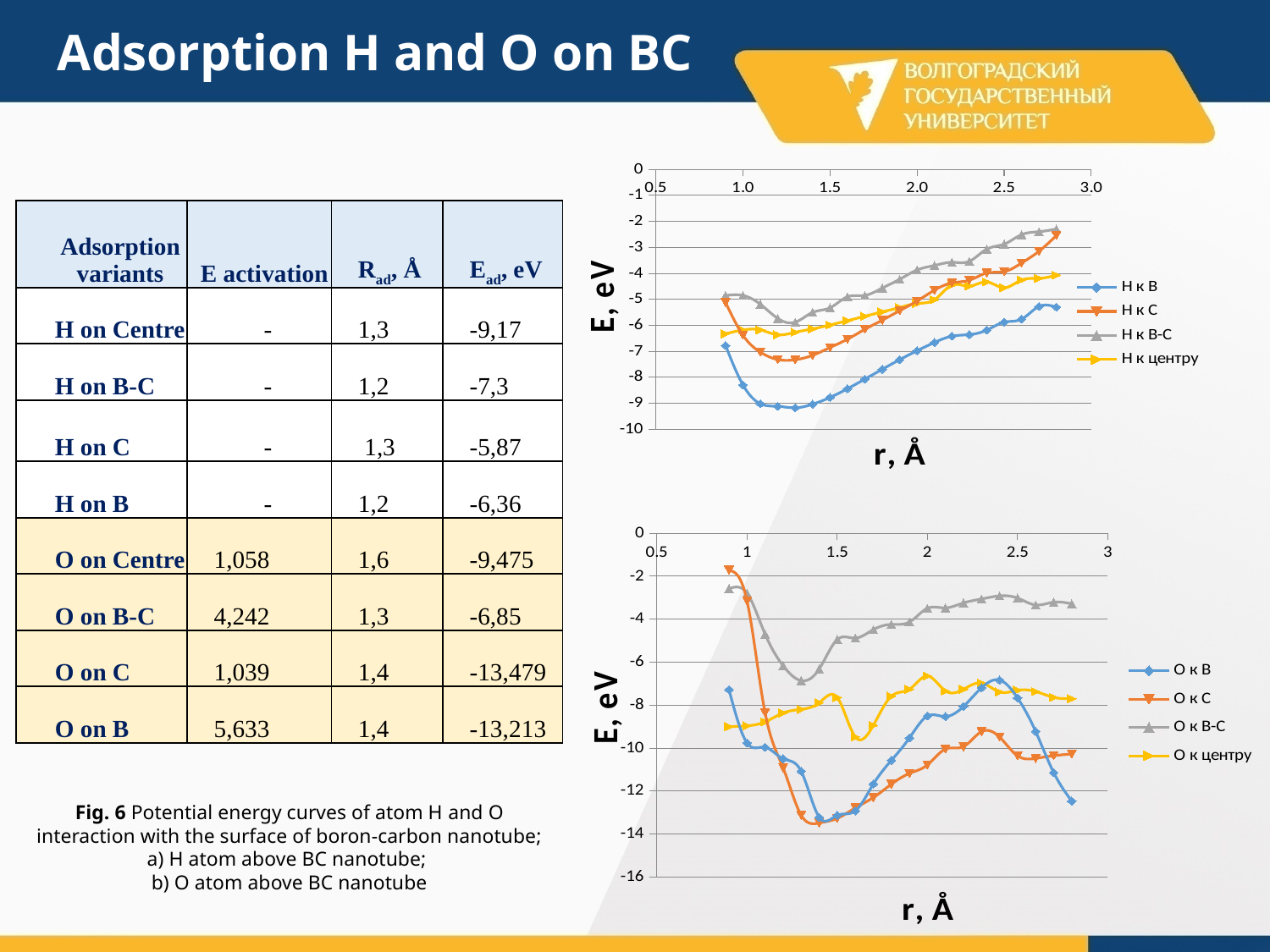
In the top chart (H atom), is the minimum value of the Н к В-С series greater or less than -7? greater How many series does the legend of the bottom chart (O atom) list? 4 In the top chart (H atom), at r = 2.0 which series has the higher energy value, Н к В-С or Н к В? Н к В-С How many series does the legend of the top chart (H atom) list? 4 What is the label of the vertical axis on the bottom chart? E, eV In the bottom chart (O atom), is the minimum value of the О к В-С series greater or less than -8? greater In the bottom chart (O atom), is the minimum value of the О к С series greater or less than -12? less In the bottom chart (O atom), which series reaches the lowest energy value? О к С What kind of chart is the top chart on the slide? line chart In the top chart (H atom), which series reaches the lowest energy value? Н к В In the top chart (H atom), does the Н к В-С series rise or fall as r increases from 1.3 to 2.8? rise